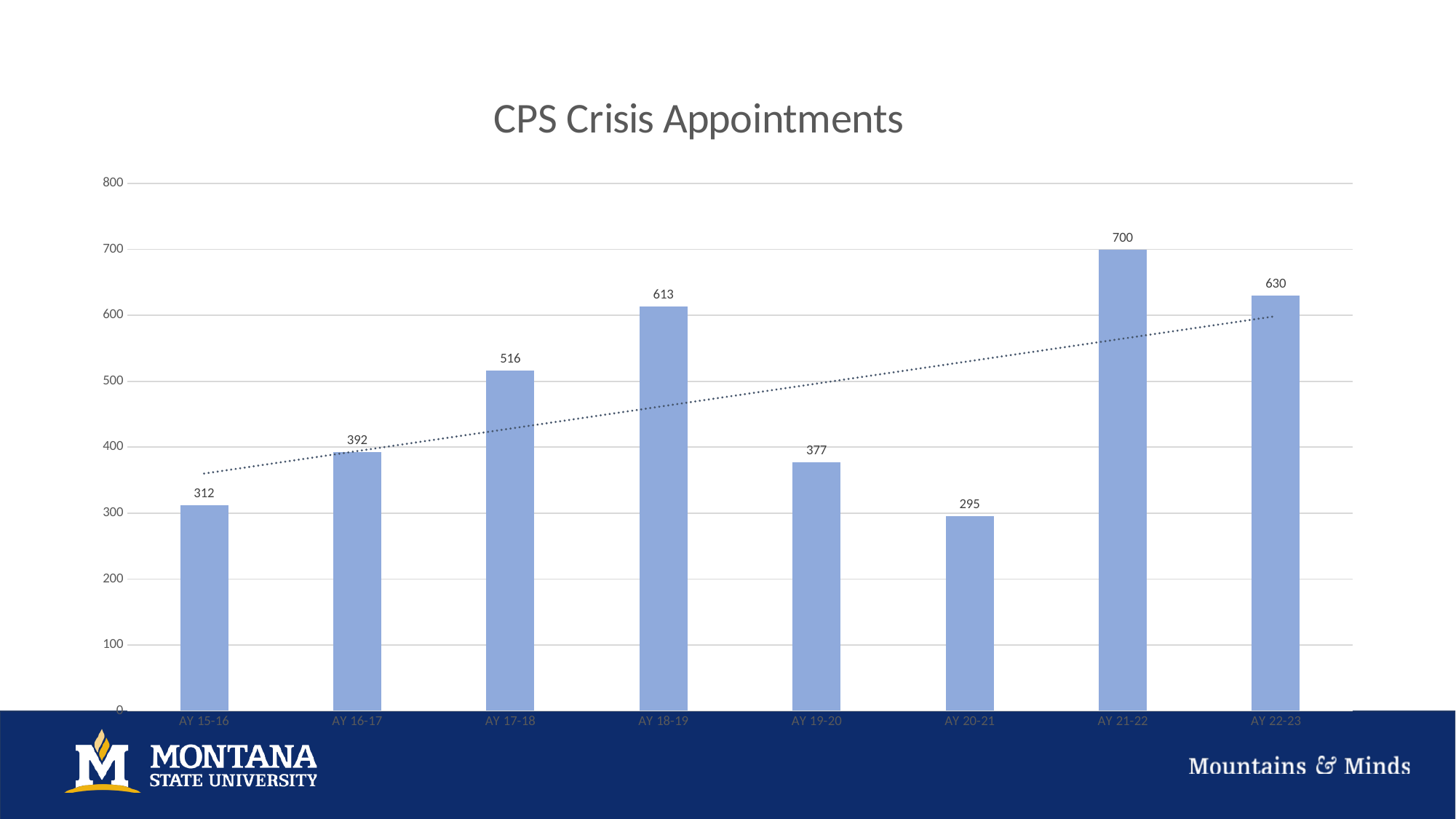
What is the value for AY 15-16? 312 What is the title of the chart? CPS Crisis Appointments What is the difference between the values for AY 17-18 and AY 16-17? 124 Which academic year has the lowest number of CPS crisis appointments? AY 20-21 Which is larger, the value for AY 19-20 or the value for AY 16-17? AY 16-17 What kind of chart is this? bar chart What is the value for AY 20-21? 295 Which academic year has the highest number of CPS crisis appointments? AY 21-22 What is the value for AY 18-19? 613 How many academic years are shown on the x axis? 8 What is the difference between the values for AY 21-22 and AY 22-23? 70 Is the value for AY 17-18 greater or less than 500? greater